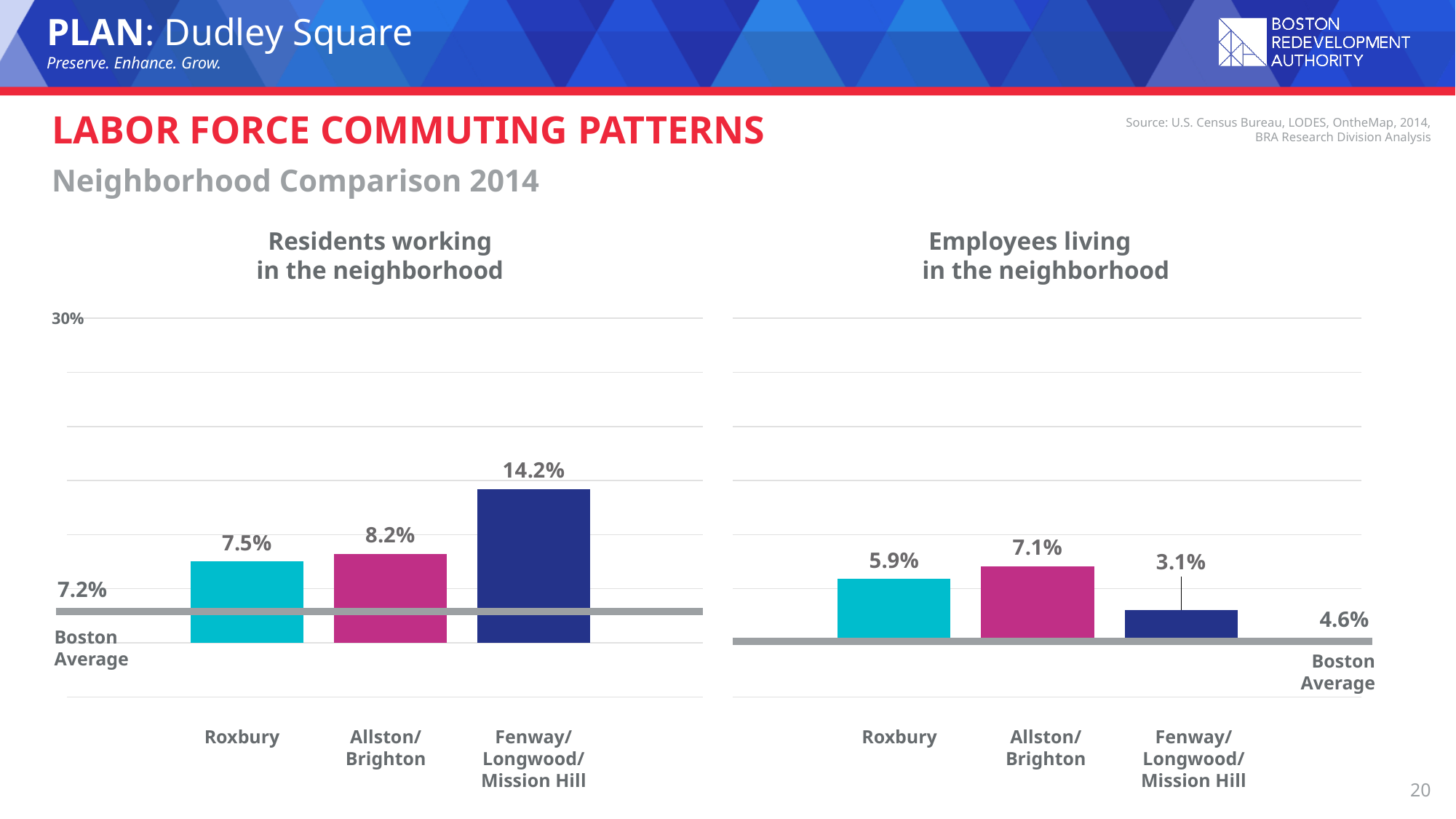
In the 'Residents working in the neighborhood' chart, which neighborhood has the highest value? Fenway/Longwood/Mission Hill How many neighborhoods are shown in the 'Residents working in the neighborhood' chart? 3 What type of chart is the 'Employees living in the neighborhood' chart? Bar chart In the 'Employees living in the neighborhood' chart, what is the difference between Allston/Brighton and Roxbury? 1.2% In the 'Employees living in the neighborhood' chart, what is the value for Fenway/Longwood/Mission Hill? 3.1% What is the Boston Average shown in the 'Employees living in the neighborhood' chart? 4.6% In the 'Employees living in the neighborhood' chart, which neighborhood has the lowest value? Fenway/Longwood/Mission Hill In the 'Employees living in the neighborhood' chart, which is larger, Roxbury or Fenway/Longwood/Mission Hill? Roxbury In the 'Residents working in the neighborhood' chart, what is the value for Roxbury? 7.5% In the 'Residents working in the neighborhood' chart, what is the value for Fenway/Longwood/Mission Hill? 14.2% In the 'Residents working in the neighborhood' chart, what is the difference between Fenway/Longwood/Mission Hill and Allston/Brighton? 6.0% In the 'Employees living in the neighborhood' chart, what is the value for Allston/Brighton? 7.1%